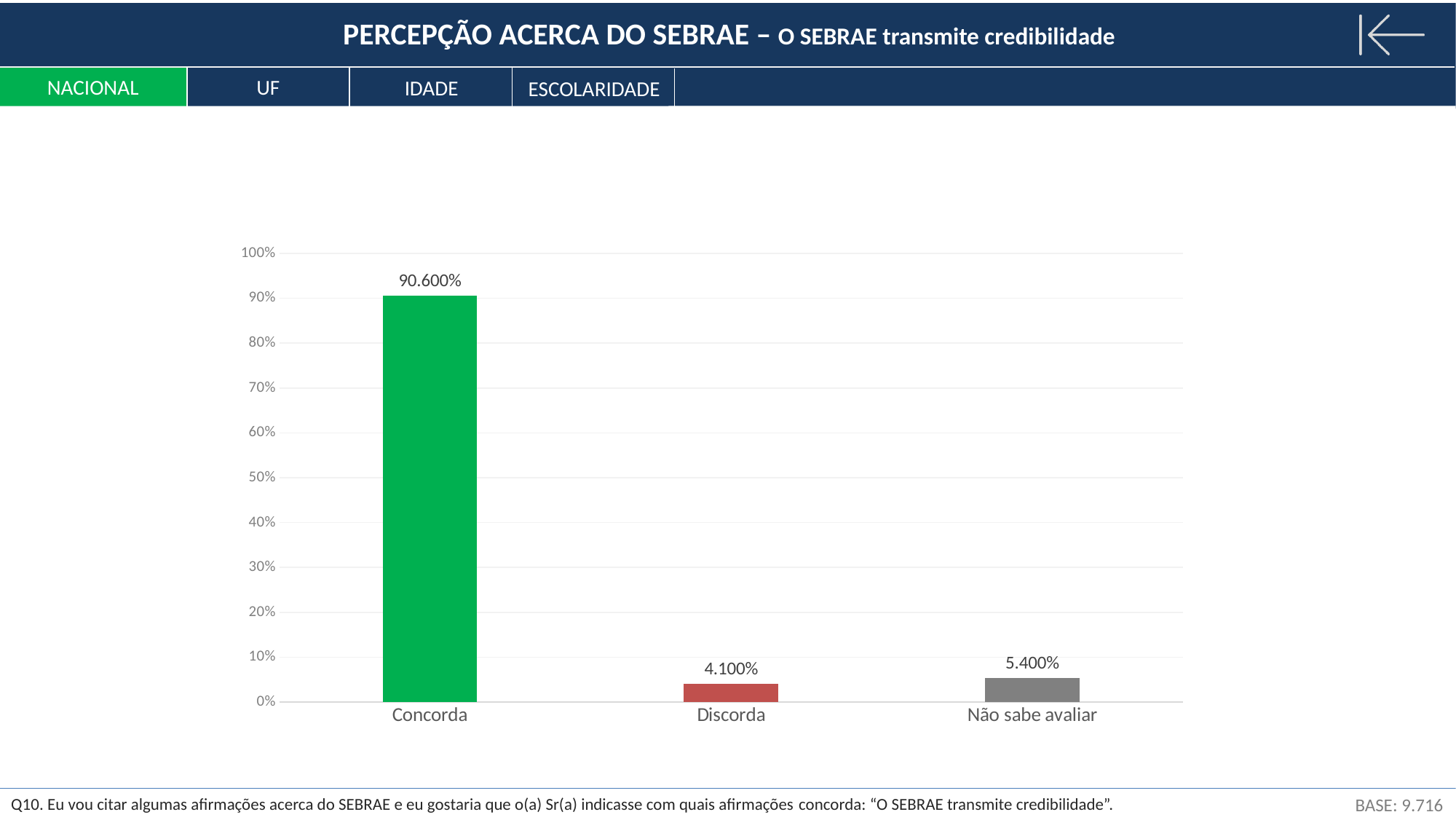
Which is larger, the value for Discorda or the value for Não sabe avaliar? Não sabe avaliar How many categories are shown on the x axis? 3 Which category has the highest value? Concorda Which category has the lowest value? Discorda Is the value for Concorda greater or less than 90%? greater What colour is the bar for Concorda? green What is the difference between the values for Não sabe avaliar and Discorda? 1.300% What is the value for Discorda? 4.100% What is the difference between the values for Concorda and Discorda? 86.500% What is the value for Concorda? 90.600% What kind of chart is shown on the slide? bar chart What is the value for Não sabe avaliar? 5.400%